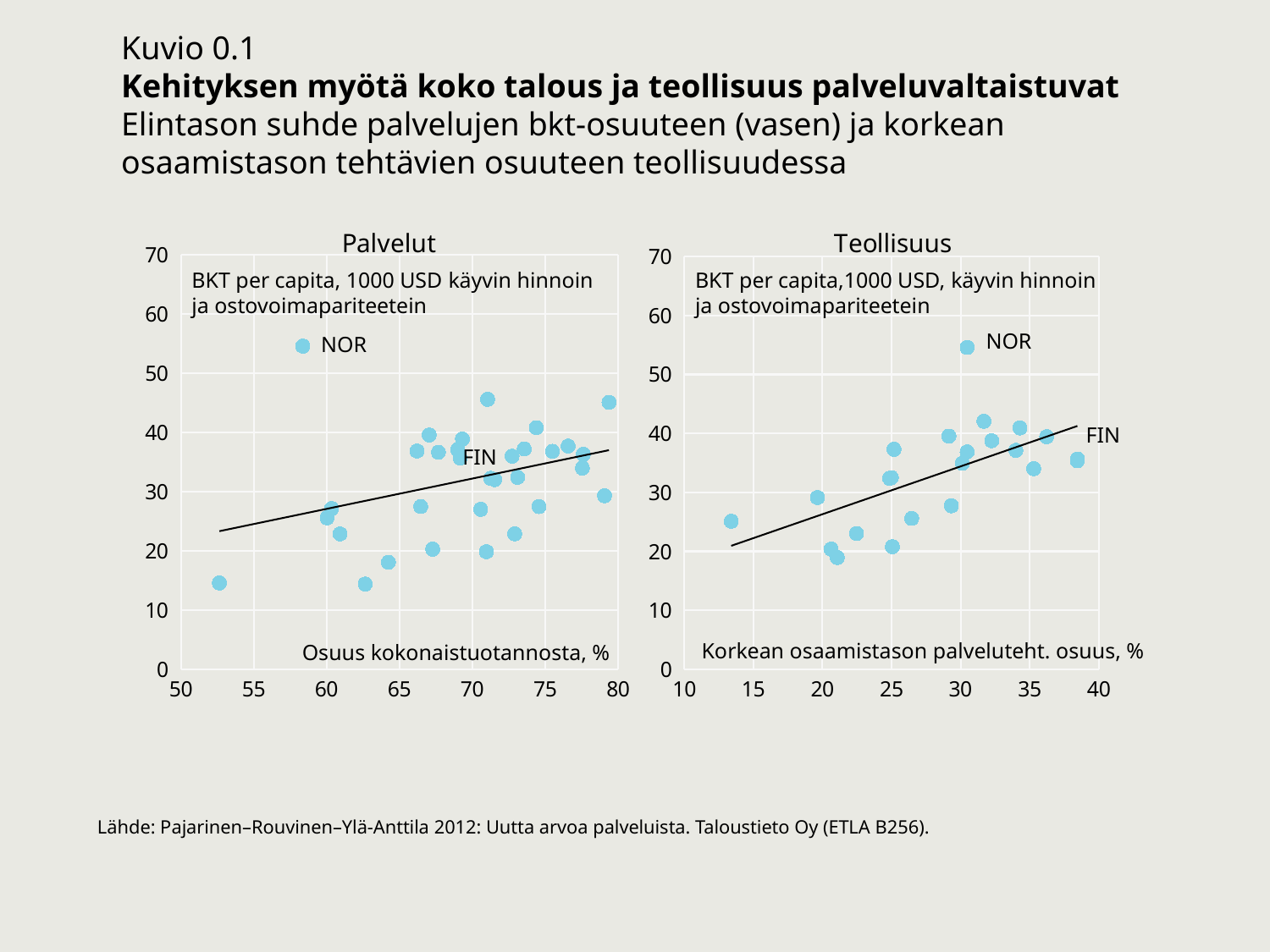
In the Palvelut chart, which labelled country has the highest BKT per capita? NOR In the Palvelut chart, is the BKT per capita value for NOR greater or less than 50? greater In the Palvelut chart, is the BKT per capita value for FIN greater or less than 30? greater What is the x-axis label of the Teollisuus chart? Korkean osaamistason palveluteht. osuus, % In the Teollisuus chart, which labelled country has the highest BKT per capita? NOR What kind of chart is the Palvelut chart on the left? scatter chart What kind of chart is the Teollisuus chart on the right? scatter chart In the Teollisuus chart, does the fitted trend line rise or fall as the x-axis value increases? rises In the Palvelut chart, which labelled country has the larger BKT per capita, NOR or FIN? NOR In the Teollisuus chart, is the BKT per capita value for NOR greater or less than 50? greater What is the x-axis label of the Palvelut chart? Osuus kokonaistuotannosta, %